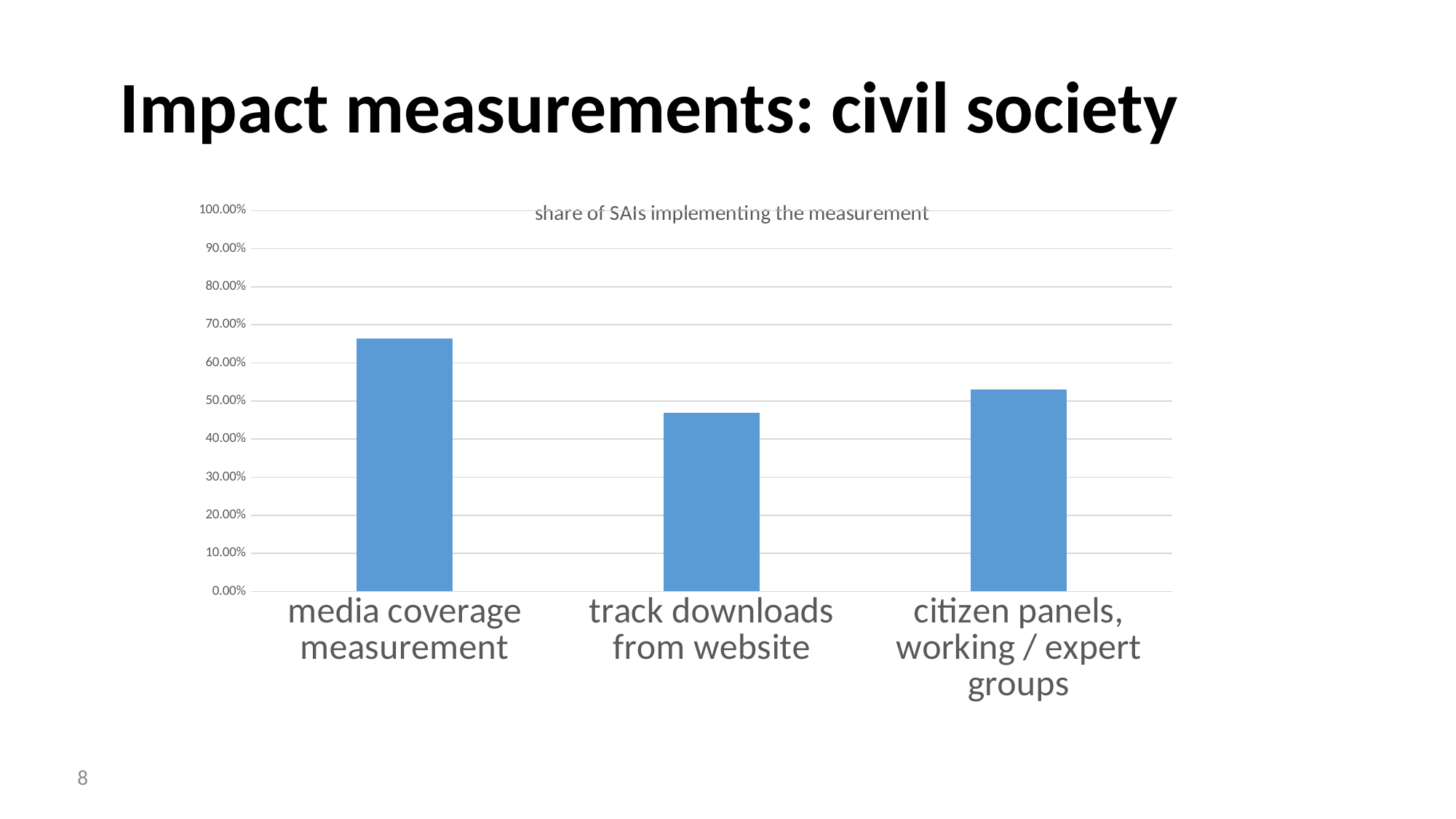
Which is larger: the value for media coverage measurement or the value for citizen panels, working / expert groups? media coverage measurement What is the title of the chart? share of SAIs implementing the measurement Is the value for media coverage measurement greater or less than 70.00%? less Which is larger: the value for citizen panels, working / expert groups or the value for track downloads from website? citizen panels, working / expert groups What kind of chart is shown on the slide? bar chart Which category has the highest share of SAIs implementing the measurement? media coverage measurement Is the value for citizen panels, working / expert groups greater or less than 60.00%? less Is the value for citizen panels, working / expert groups greater or less than 50.00%? greater Which category has the lowest share of SAIs implementing the measurement? track downloads from website How many categories are shown on the x axis of the chart? 3